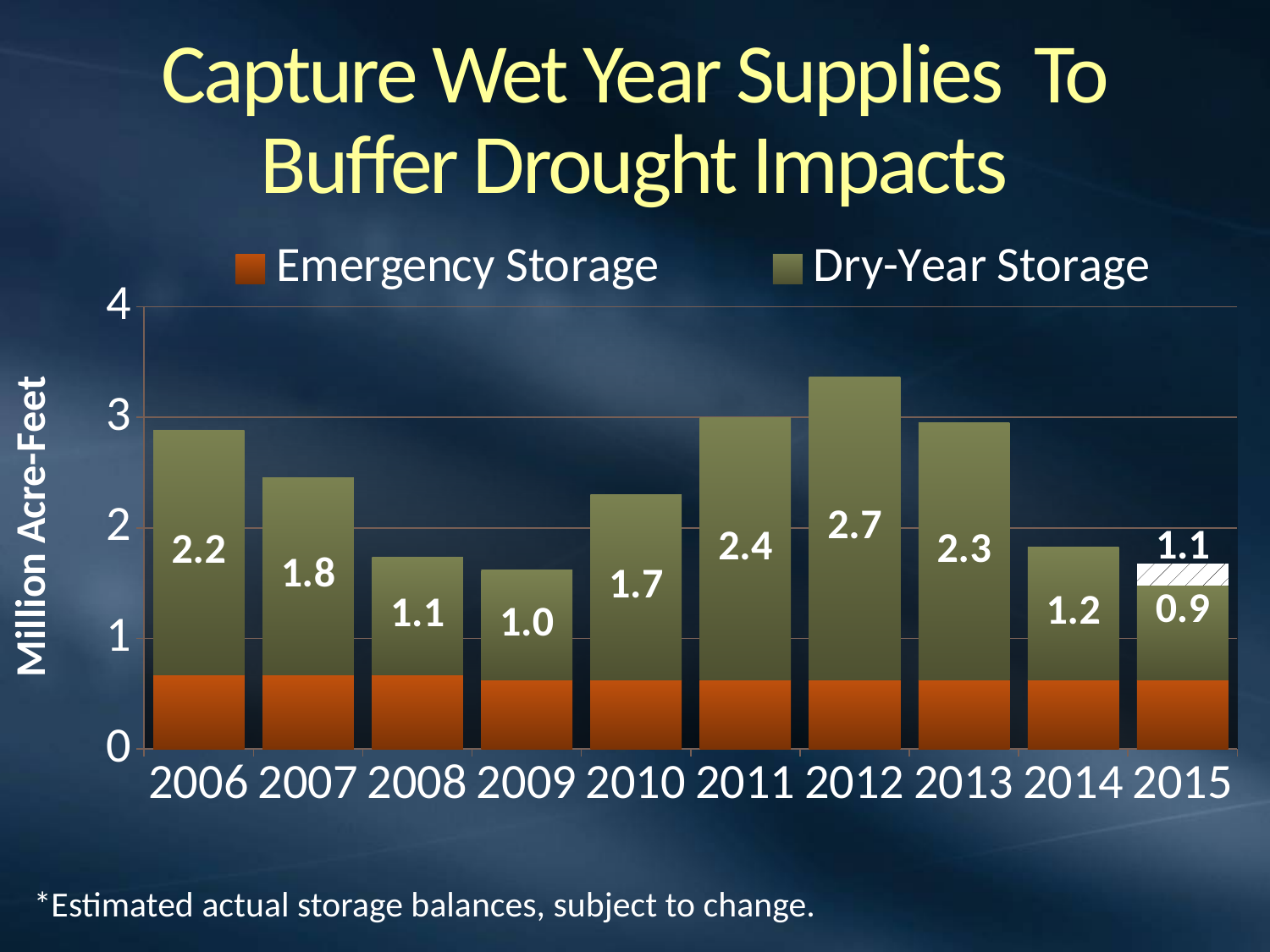
What kind of chart is shown on the slide? Stacked bar chart How many series does the legend list? 2 What is the Dry-Year Storage value for 2014? 1.2 How many years are shown on the x axis? 10 Which year has the lowest labeled Dry-Year Storage value? 2015 Which year has the highest labeled Dry-Year Storage value? 2012 What is the difference between the Dry-Year Storage values for 2012 and 2013? 0.4 Which year has a larger Dry-Year Storage value, 2006 or 2011? 2011 Is the total height of the 2012 bar greater or less than 3? greater What is the Dry-Year Storage value for 2012? 2.7 What is the Dry-Year Storage value for 2009? 1.0 Is the total height of the 2009 bar greater or less than 2? less